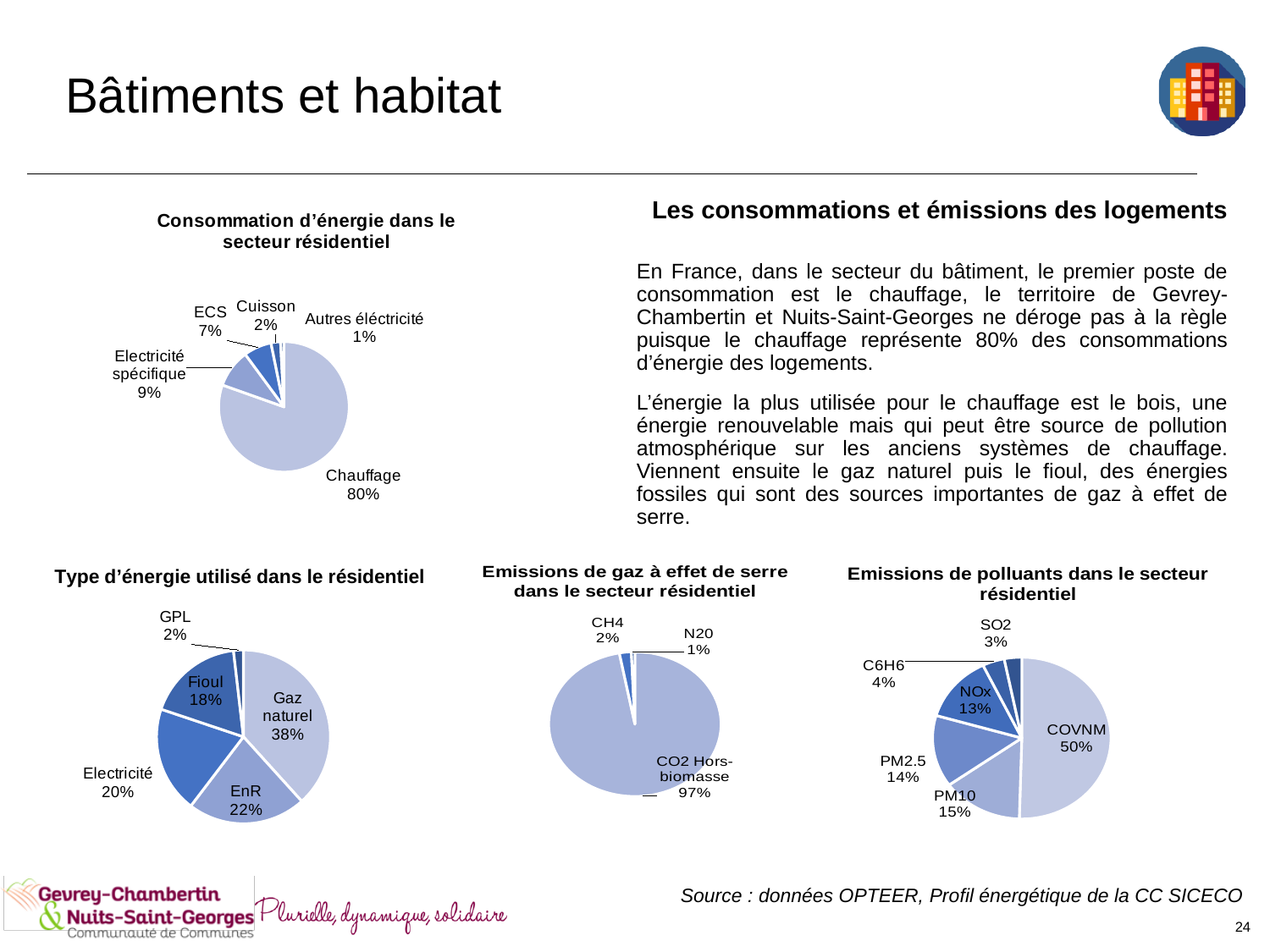
In the chart 'Consommation d'énergie dans le secteur résidentiel', which category has the smallest share? Autres éléctricité In the chart 'Consommation d'énergie dans le secteur résidentiel', what share does Chauffage represent? 80% In the chart 'Emissions de polluants dans le secteur résidentiel', what is the share of PM10? 15% In the chart 'Emissions de gaz à effet de serre dans le secteur résidentiel', what share does CO2 Hors-biomasse represent? 97% How many categories are shown in the chart 'Emissions de gaz à effet de serre dans le secteur résidentiel'? 3 In the chart 'Emissions de polluants dans le secteur résidentiel', which pollutant has the smallest share? SO2 What type of chart is 'Emissions de polluants dans le secteur résidentiel'? Pie chart In the chart 'Type d'énergie utilisé dans le résidentiel', what is the difference between the shares of EnR and Fioul? 4% How many slices does the chart 'Consommation d'énergie dans le secteur résidentiel' have? 5 In the chart 'Type d'énergie utilisé dans le résidentiel', which is larger, Electricité or Fioul? Electricité In the chart 'Type d'énergie utilisé dans le résidentiel', which energy type has the largest share? Gaz naturel